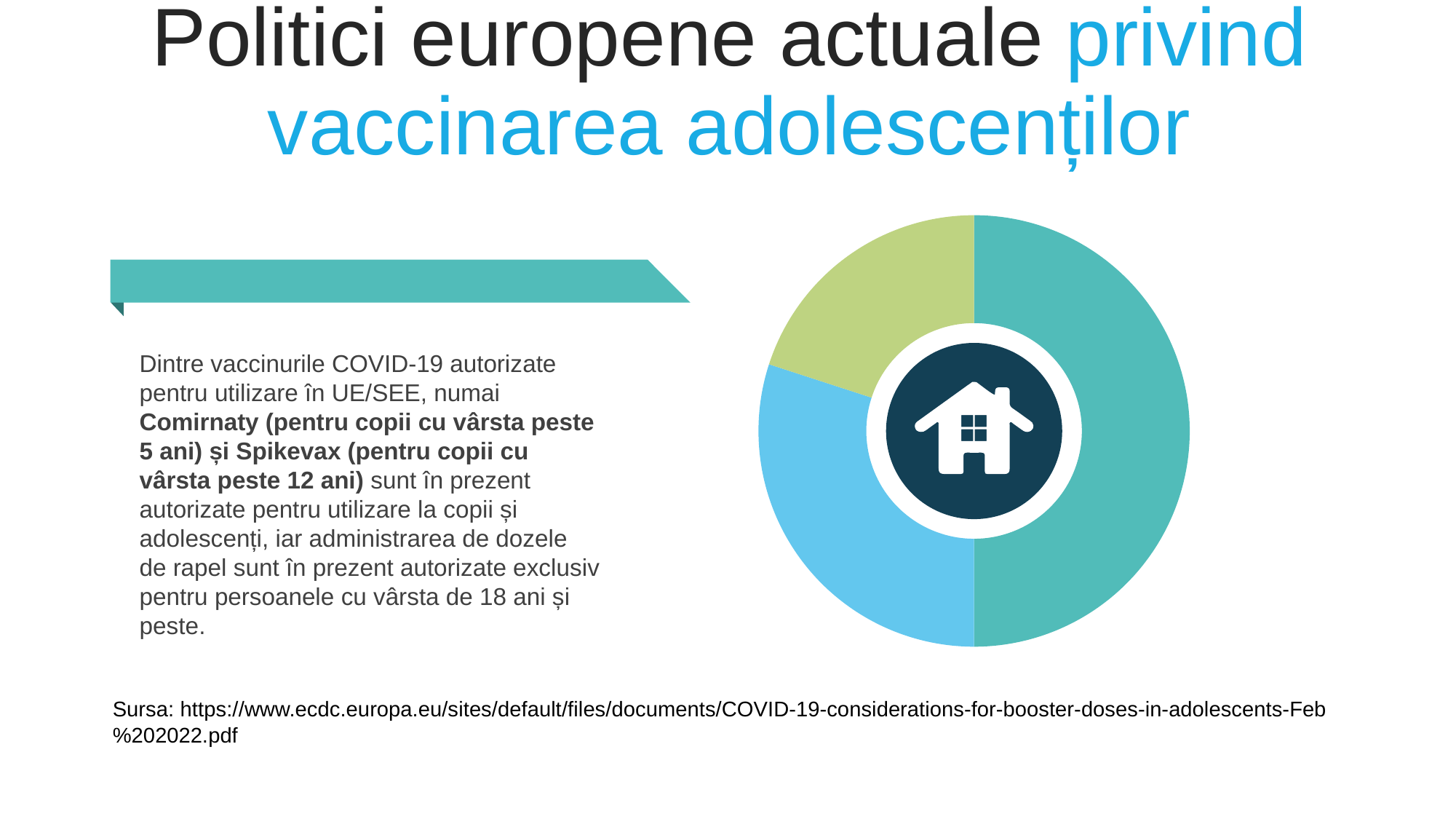
Does the doughnut chart on the slide display a legend? No Is the blue slice of the doughnut chart larger or smaller than the green slice? Larger What icon appears in the centre of the doughnut chart? A house What kind of chart is shown on the right side of the slide? Doughnut (pie) chart Which colour slice of the doughnut chart is the smallest? Green How many slices does the doughnut chart on the slide have? 3 Which colour slice of the doughnut chart is the largest? Teal